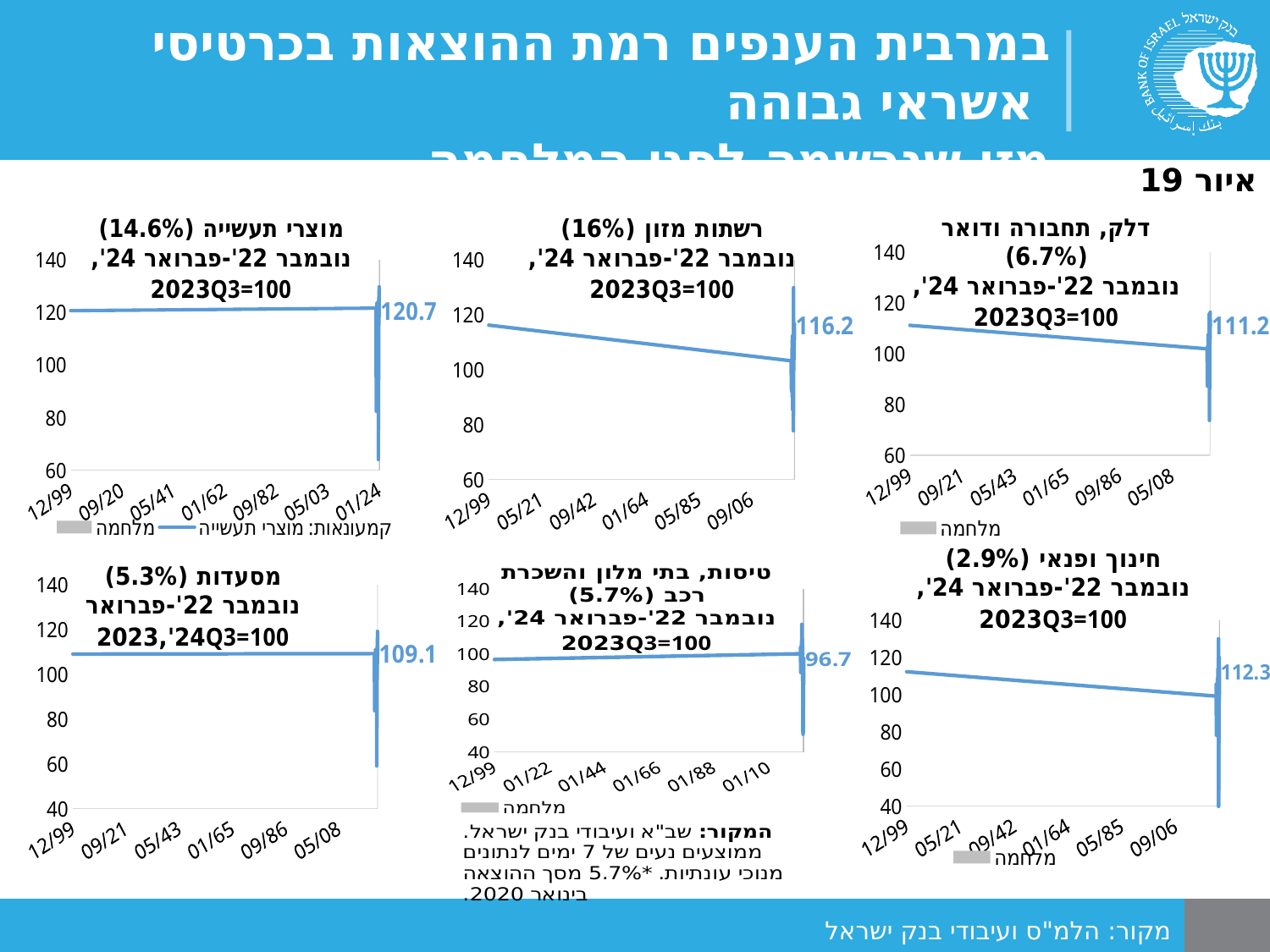
What is the difference between the final data label of the "מוצרי תעשייה (14.6%)" chart and that of the "רשתות מזון (16%)" chart? 4.5 What is the final data label shown on the chart titled "טיסות, בתי מלון והשכרת רכב (5.7%)"? 96.7 What is the final data label shown on the chart titled "חינוך ופנאי (2.9%)"? 112.3 Across the six charts on the slide, which chart shows the lowest final data label? טיסות, בתי מלון והשכרת רכב (5.7%) What is the final data label shown on the chart titled "דלק, תחבורה ודואר (6.7%)"? 111.2 How many charts are shown on the slide? 6 What is the final data label shown on the chart titled "מוצרי תעשייה (14.6%)"? 120.7 Across the six charts on the slide, which chart shows the highest final data label? מוצרי תעשייה (14.6%) What is the final data label shown on the chart titled "מסעדות (5.3%)"? 109.1 Which final data label is larger: the one on the "חינוך ופנאי (2.9%)" chart or the one on the "מסעדות (5.3%)" chart? חינוך ופנאי (2.9%) What kind of chart is the "רשתות מזון (16%)" chart? line chart What is the final data label shown on the chart titled "רשתות מזון (16%)"? 116.2